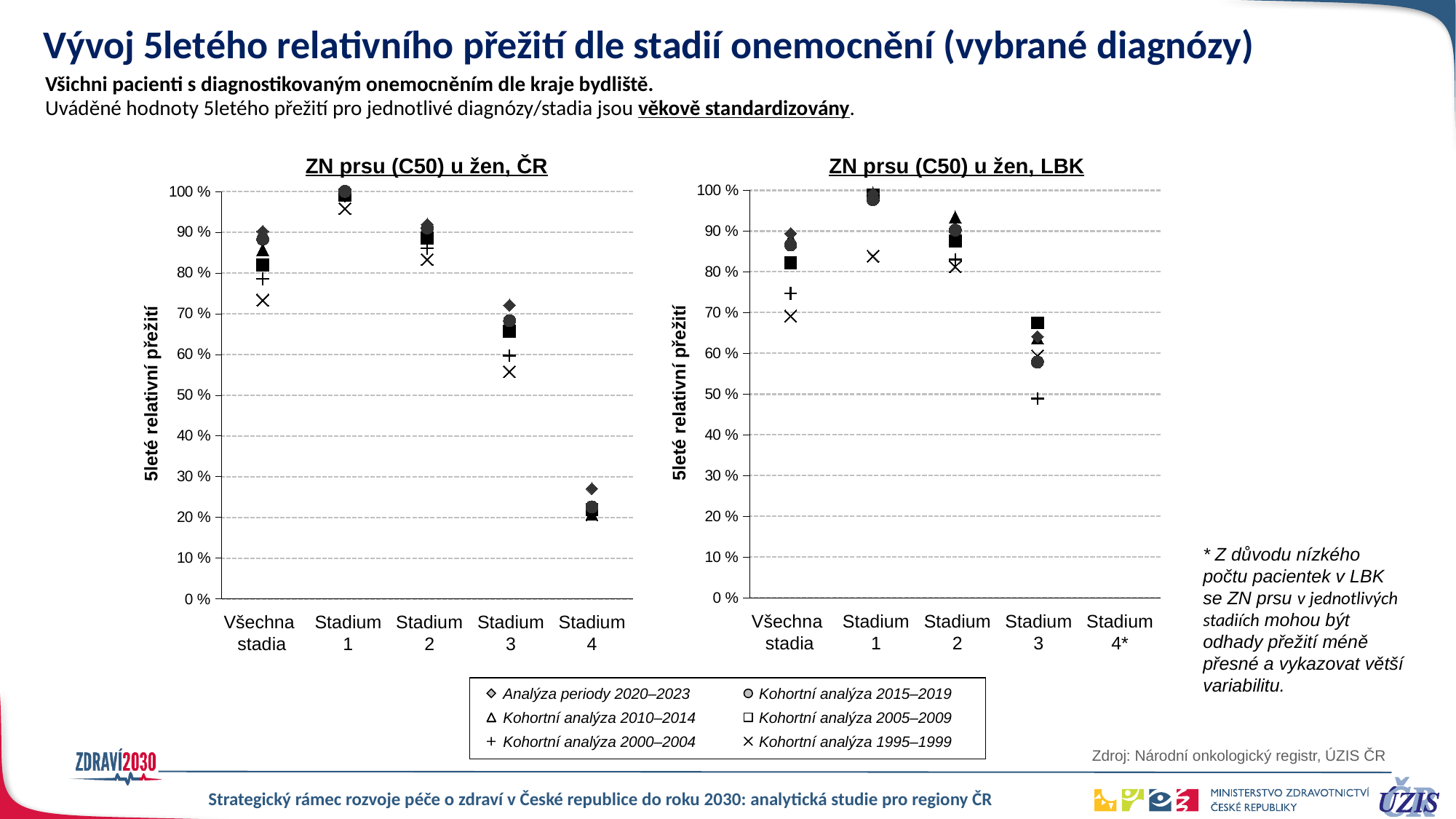
In the right chart, 'ZN prsu (C50) u žen, LBK', which is higher for Stadium 3: Kohortní analýza 2005–2009 or Kohortní analýza 2000–2004? Kohortní analýza 2005–2009 What kind of chart is the left chart, 'ZN prsu (C50) u žen, ČR'? scatter chart In the left chart, 'ZN prsu (C50) u žen, ČR', do the values rise or fall from Stadium 1 to Stadium 4? fall In the right chart, 'ZN prsu (C50) u žen, LBK', is the value for Všechna stadia in the Kohortní analýza 1995–1999 series greater or less than 80 %? less In the right chart, 'ZN prsu (C50) u žen, LBK', is the value for Stadium 3 in the Kohortní analýza 2000–2004 series greater or less than 60 %? less How many series does the shared legend list for the charts? 6 In the right chart, 'ZN prsu (C50) u žen, LBK', how many x-axis categories have plotted points? 4 How many categories are shown on the x axis of the left chart, 'ZN prsu (C50) u žen, ČR'? 5 In the left chart, 'ZN prsu (C50) u žen, ČR', which is higher for Stadium 3: Analýza periody 2020–2023 or Kohortní analýza 1995–1999? Analýza periody 2020–2023 In the left chart, 'ZN prsu (C50) u žen, ČR', is the value for Stadium 1 in the Kohortní analýza 1995–1999 series greater or less than 90 %? greater In the left chart, 'ZN prsu (C50) u žen, ČR', which stage has the highest survival values? Stadium 1